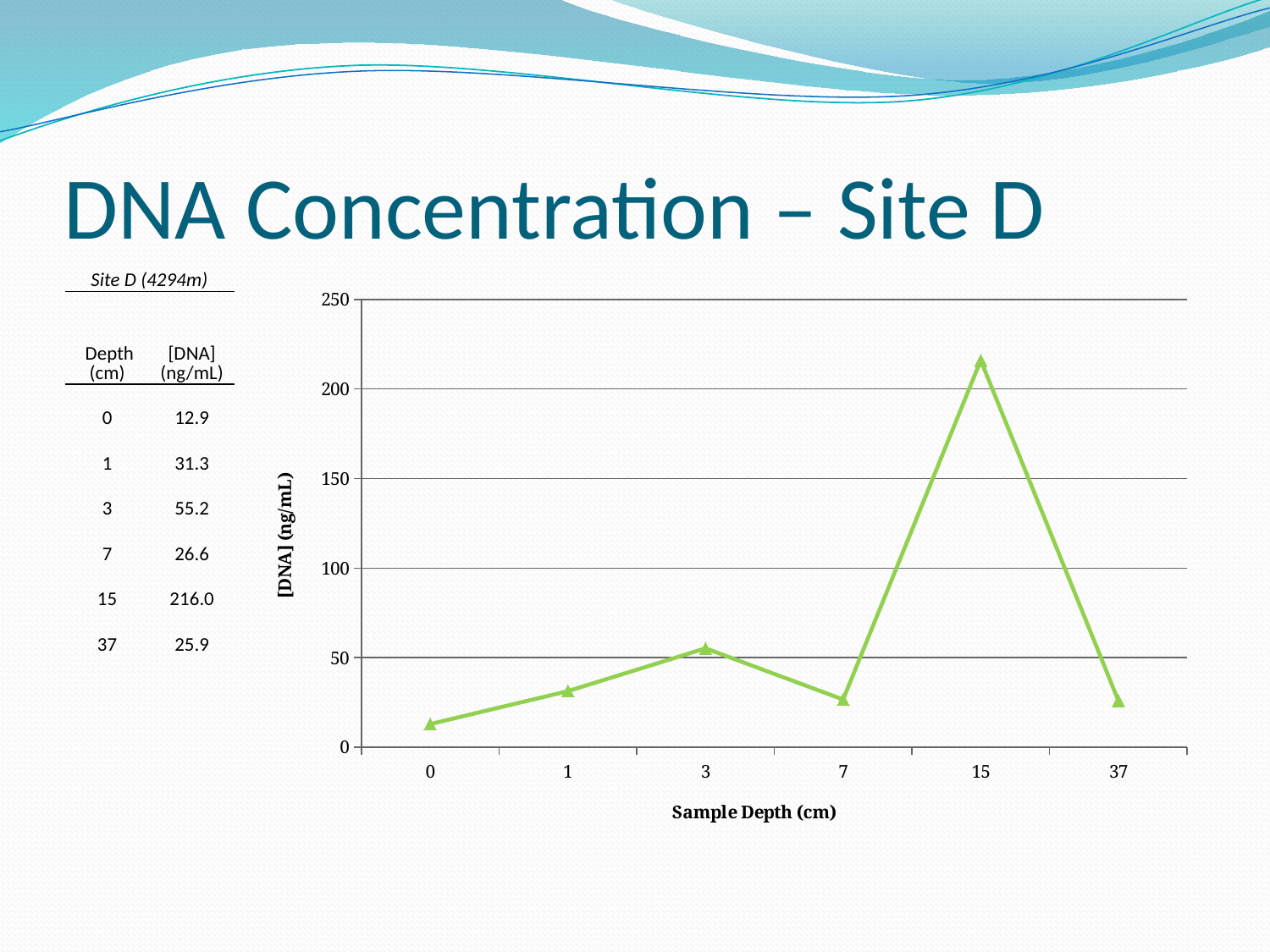
What is the label of the y axis of the chart? [DNA] (ng/mL) What kind of chart is shown on the slide? line chart What is the DNA concentration at a sample depth of 0 cm? 12.9 What is the difference in DNA concentration between the 15 cm and 3 cm sample depths? 160.8 At which sample depth is the DNA concentration highest? 15 What is the DNA concentration at a sample depth of 3 cm? 55.2 Does the DNA concentration rise or fall between the 3 cm and 7 cm sample depths? fall Is the DNA concentration at a sample depth of 15 cm greater or less than 200? greater What is the DNA concentration at a sample depth of 15 cm? 216.0 Which sample depth has a higher DNA concentration, 1 cm or 7 cm? 1 At which sample depth is the DNA concentration lowest? 0 How many sample depths are plotted on the chart? 6